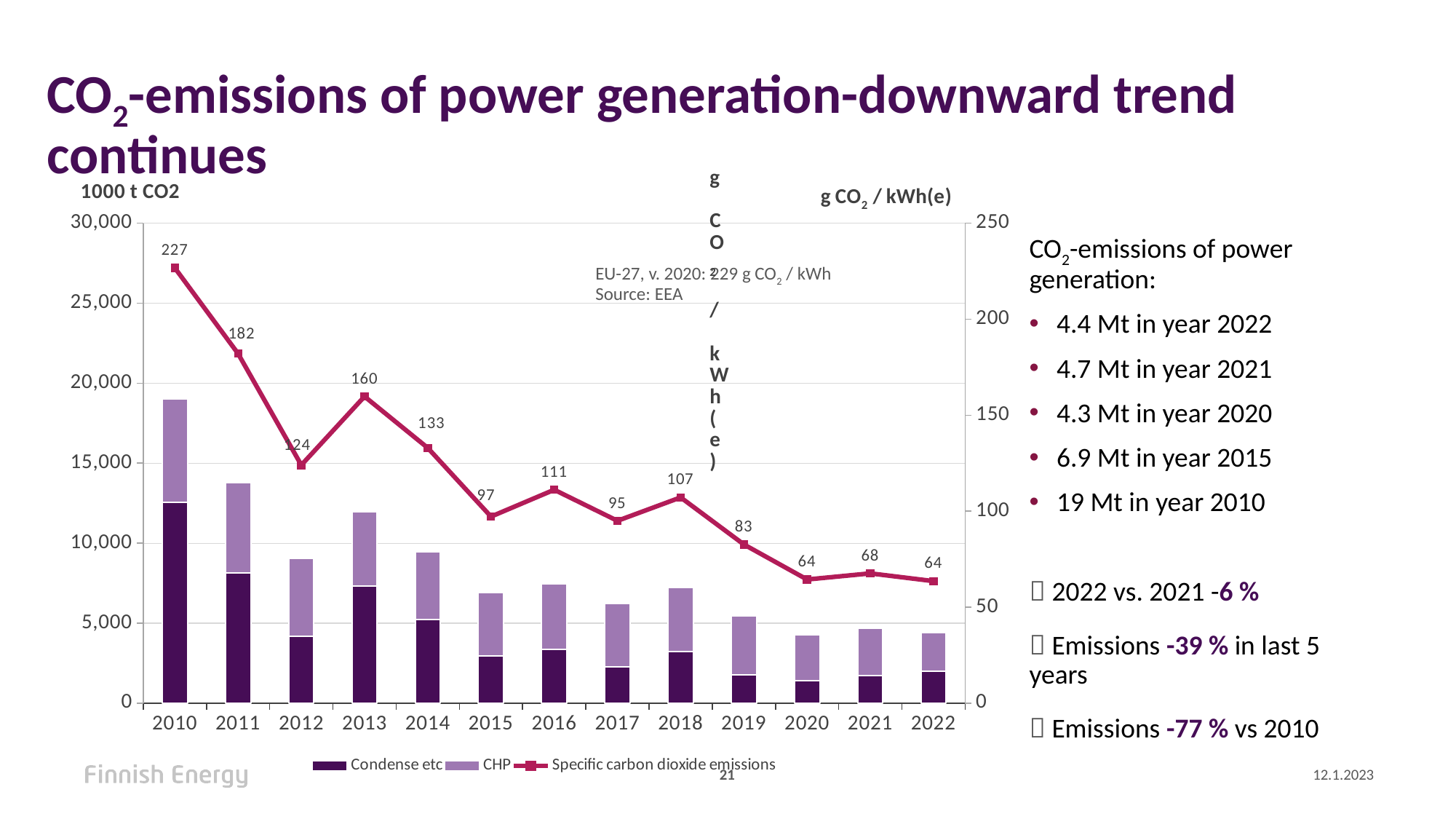
How many years are shown on the x axis? 13 Which year has the larger specific carbon dioxide emissions value, 2016 or 2018? 2016 In which year is the specific carbon dioxide emissions value highest? 2010 What kind of chart is shown? Combined stacked bar and line chart How many series does the legend list? 3 Is the total stacked bar value for 2010 greater or less than 15,000? greater What is the specific carbon dioxide emissions value for 2015? 97 What is the specific carbon dioxide emissions value for 2022? 64 What is the difference between the specific carbon dioxide emissions values for 2013 and 2012? 36 What is the difference between the specific carbon dioxide emissions values for 2010 and 2022? 163 Is the total stacked bar value for 2022 greater or less than 5,000? less What is the specific carbon dioxide emissions value for 2010? 227